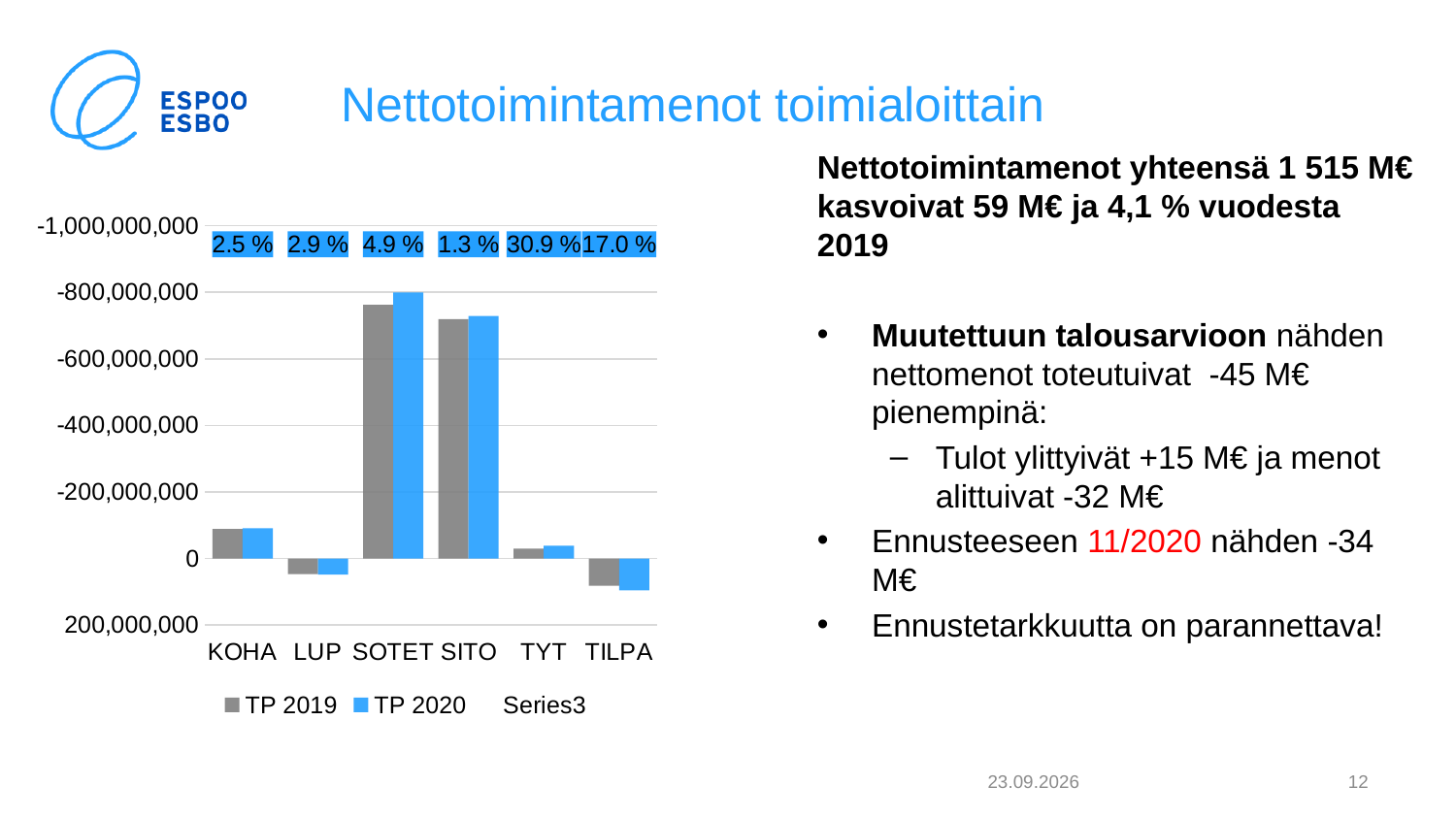
What kind of chart is shown on the slide? bar chart Which category has the highest percentage label in the chart? TYT Is the TP 2019 value for SITO greater or less than -600,000,000? less What percentage label is shown above the TYT category? 30.9 % How many categories are shown on the x axis of the chart? 6 What colour are the TP 2020 bars in the chart? blue Which category has the longest bars in the chart? SOTET What is the difference between the percentage labels for TYT and TILPA? 13.9 % What percentage label is shown above the KOHA category? 2.5 % How many series does the chart legend list? 3 Which category has the lowest percentage label in the chart? SITO What percentage label is shown above the TILPA category? 17.0 %